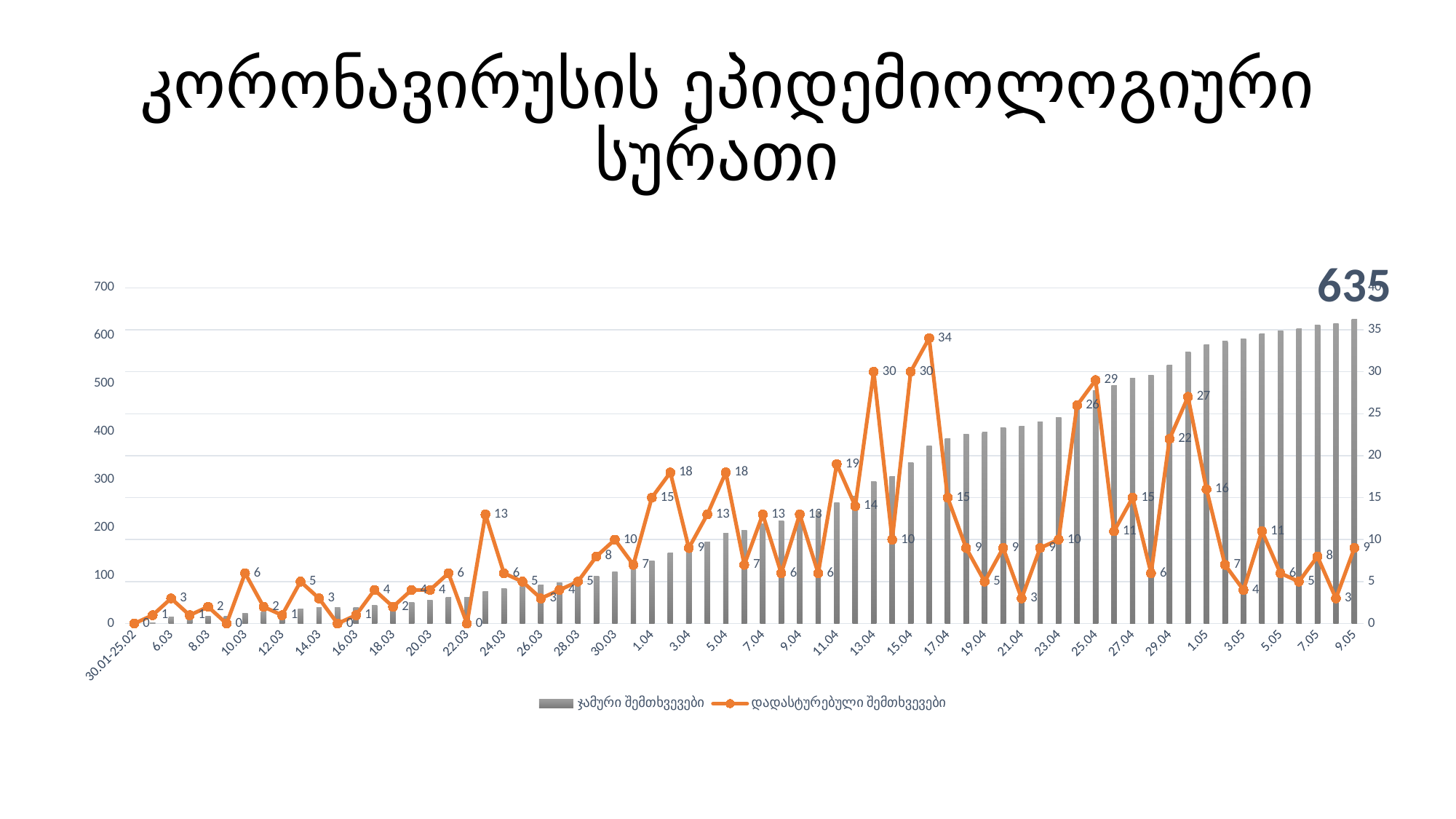
What is the value of the orange line (დადასტურებული შემთხვევები) at 9.05? 9 How many series does the legend list? 2 What is the difference between the orange line values at 25.04 and 27.04? 14 Is the bar (ჯამური შემთხვევები) at 1.04 greater or less than 200 on the left axis? less Is the bar (ჯამური შემთხვევები) at 1.05 greater or less than 500 on the left axis? greater What is the value of the orange line (დადასტურებული შემთხვევები) at 3.04? 9 What is the highest value shown on the orange line (დადასტურებული შემთხვევები)? 34 What kind of chart is shown on the slide? Combination bar and line chart What is the value of the orange line (დადასტურებული შემთხვევები) at 13.04? 30 What is the value of the orange line (დადასტურებული შემთხვევები) at 25.04? 29 What is the value printed above the last bar (ჯამური შემთხვევები) at 9.05? 635 Which date has the larger orange line value, 11.04 or 7.04? 11.04